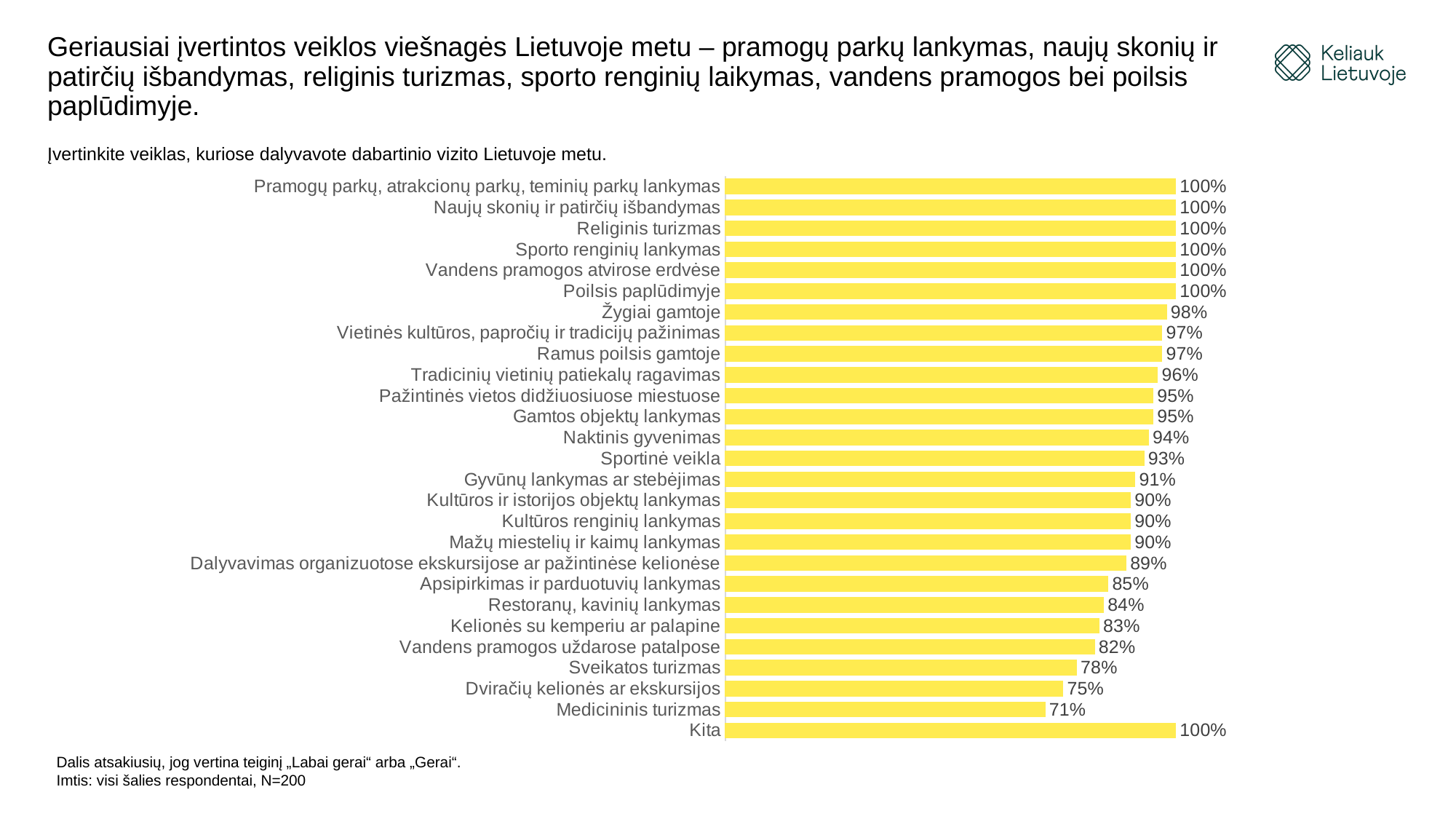
What is the difference between the values for Religinis turizmas and Sveikatos turizmas? 22% What colour are the bars in the chart? Yellow How many categories are shown in the chart? 27 What is the value for Sveikatos turizmas? 78% Which category has the lowest value? Medicininis turizmas What kind of chart is shown on the slide? Bar chart What is the value for Medicininis turizmas? 71% What is the value for Žygiai gamtoje? 98% What is the difference between the values for Naktinis gyvenimas and Dviračių kelionės ar ekskursijos? 19% Which is larger, the value for Sportinė veikla or the value for Kelionės su kemperiu ar palapine? Sportinė veikla Which is larger, the value for Apsipirkimas ir parduotuvių lankymas or the value for Vandens pramogos uždarose patalpose? Apsipirkimas ir parduotuvių lankymas What is the value for Restoranų, kavinių lankymas? 84%